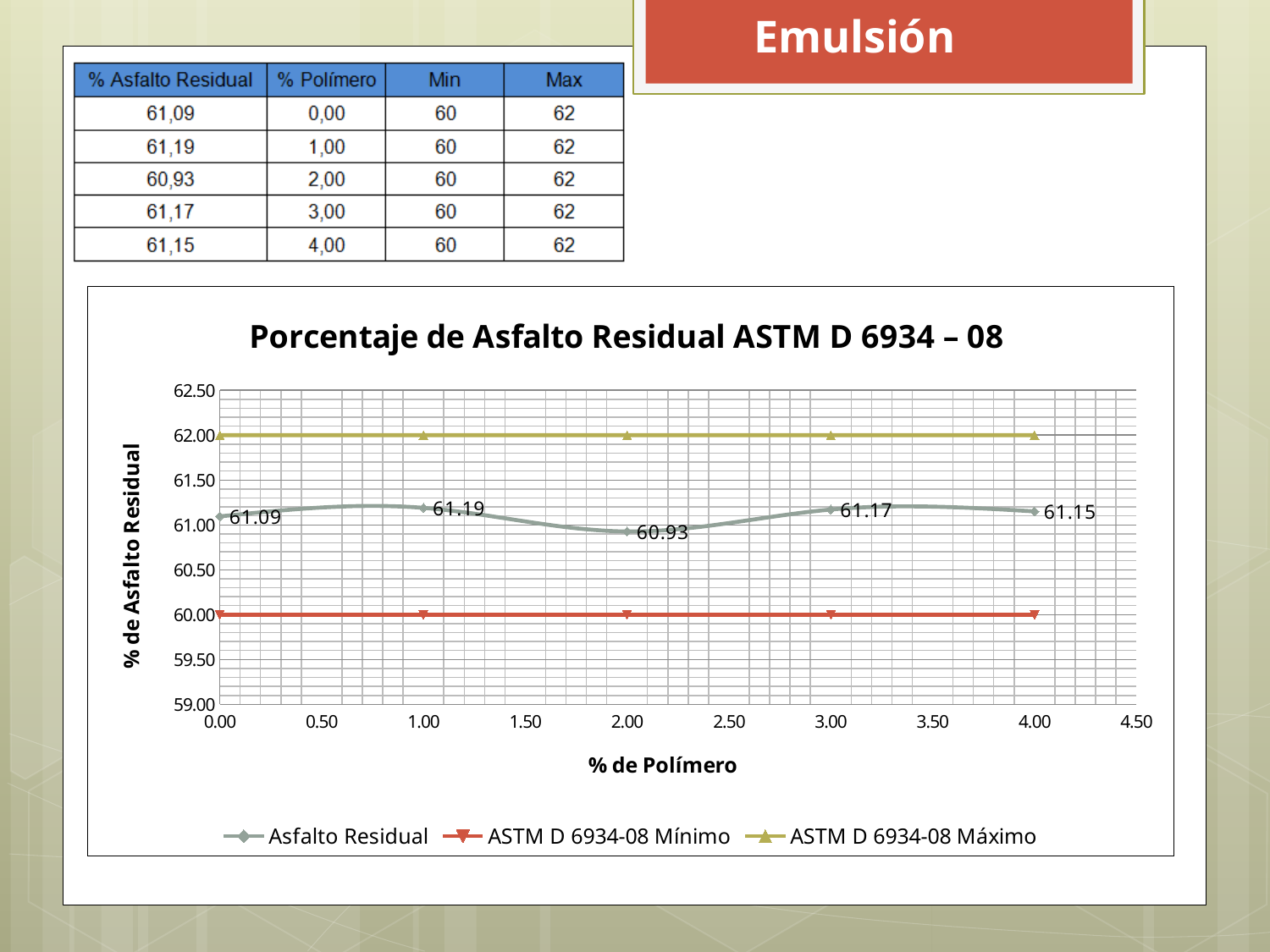
What is the Asfalto Residual value at 2.00 % de Polímero? 60.93 Which is larger, the Asfalto Residual value at 3.00 or at 2.00 % de Polímero? 3.00 What is the Asfalto Residual value at 4.00 % de Polímero? 61.15 At which % de Polímero is the Asfalto Residual value highest? 1.00 What is the title of the chart? Porcentaje de Asfalto Residual ASTM D 6934 – 08 Is the ASTM D 6934-08 Máximo line greater or less than 61.50 on the y axis? greater What is the difference between the Asfalto Residual values at 1.00 and 2.00 % de Polímero? 0.26 How many series does the chart legend list? 3 What kind of chart is shown on the slide? line chart At which % de Polímero is the Asfalto Residual value lowest? 2.00 How many data points does the Asfalto Residual series have? 5 What is the Asfalto Residual value at 0.00 % de Polímero? 61.09